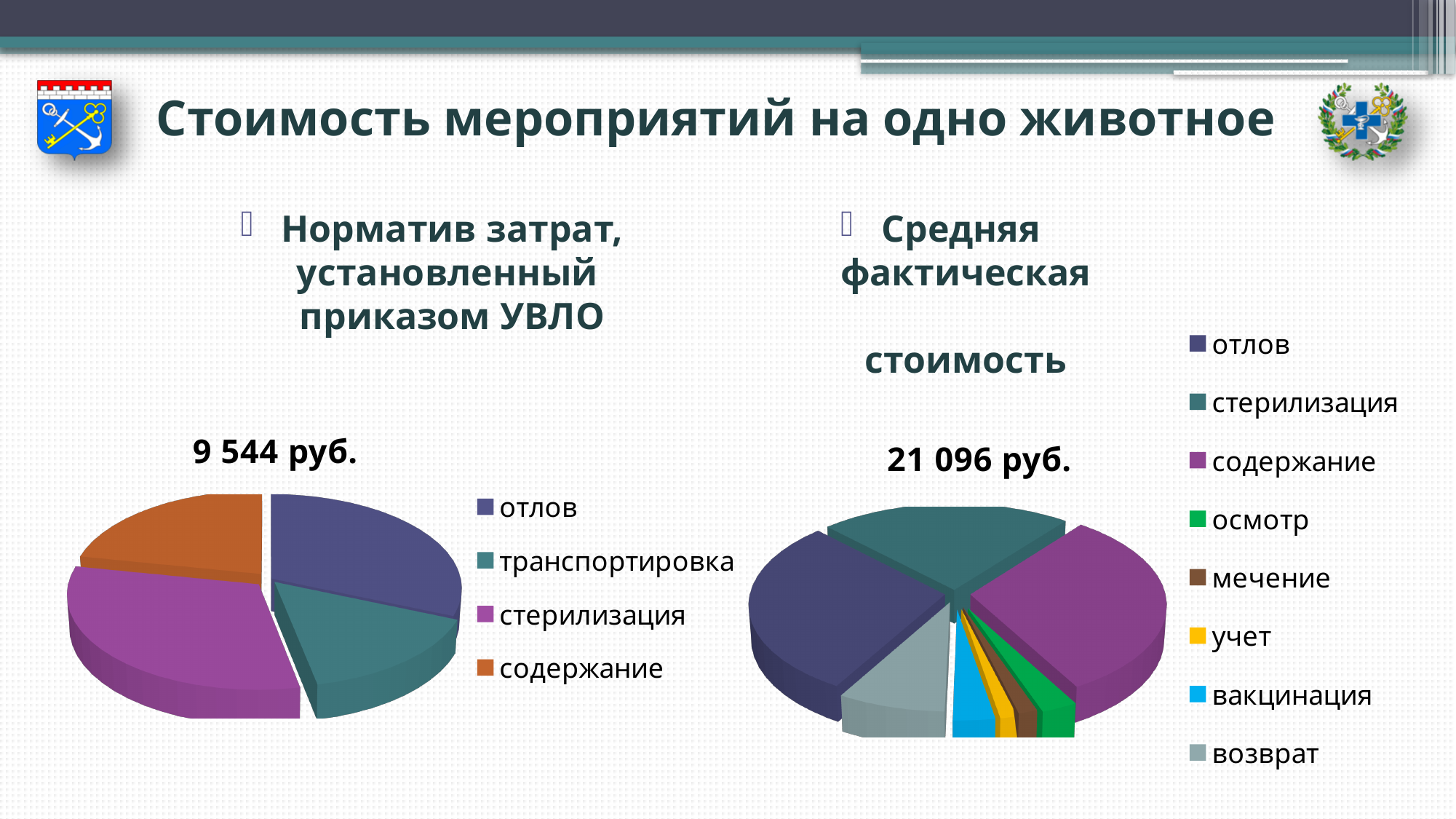
What kind of chart is used on the right side of the slide (Средняя фактическая стоимость)? pie chart In the left chart (Норматив затрат), which category is shown in orange? содержание In the right chart (Средняя фактическая стоимость), which slice is larger: возврат or вакцинация? возврат In the right chart (Средняя фактическая стоимость), which slice is larger: отлов or учет? отлов What kind of chart is used on the left side of the slide (Норматив затрат, установленный приказом УВЛО)? pie chart In the right chart (Средняя фактическая стоимость), which slice is larger: содержание or осмотр? содержание What total amount is printed above the right chart (Средняя фактическая стоимость)? 21 096 руб. How many categories does the legend of the right chart (Средняя фактическая стоимость) list? 8 What total amount is printed above the left chart (Норматив затрат, установленный приказом УВЛО)? 9 544 руб. How many categories does the legend of the left chart (Норматив затрат) list? 4 In the right chart (Средняя фактическая стоимость), which category is shown in green? осмотр